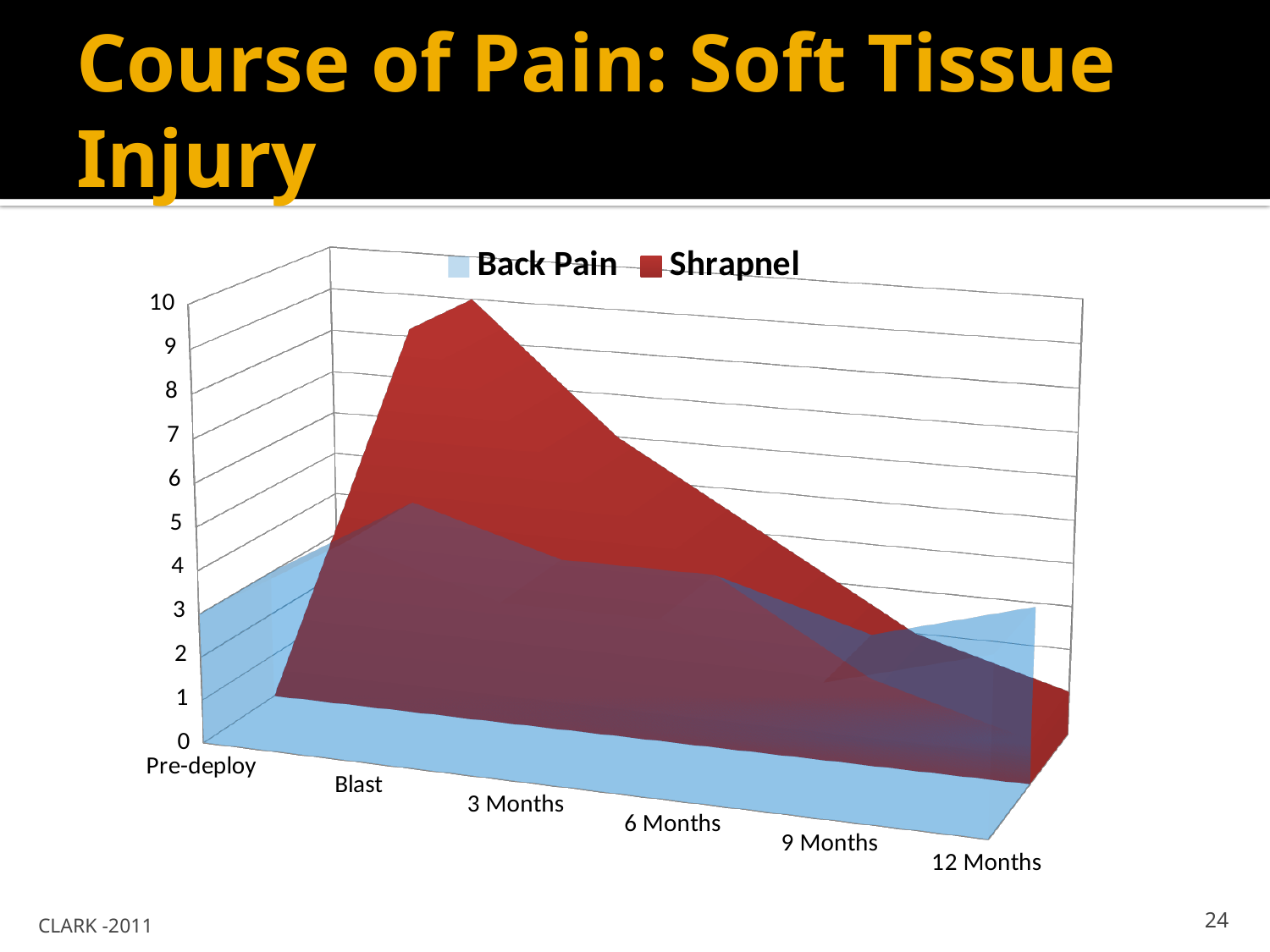
How many series does the legend list? 2 How many time points are shown along the x axis? 6 Which series is shown in red? Shrapnel What kind of chart is shown on the slide? Area chart Is the Shrapnel value at Pre-deploy greater or less than 2? less At which time point is the Shrapnel series lowest? Pre-deploy What is the title of the slide containing the chart? Course of Pain: Soft Tissue Injury Is the Shrapnel value at 12 Months greater or less than 4? less Does the Shrapnel series rise or fall from Blast to 12 Months? Fall Is the Shrapnel value at Blast greater or less than 5? greater At which time point does the Shrapnel series reach its highest value? Blast At Blast, which series has the larger value, Back Pain or Shrapnel? Shrapnel